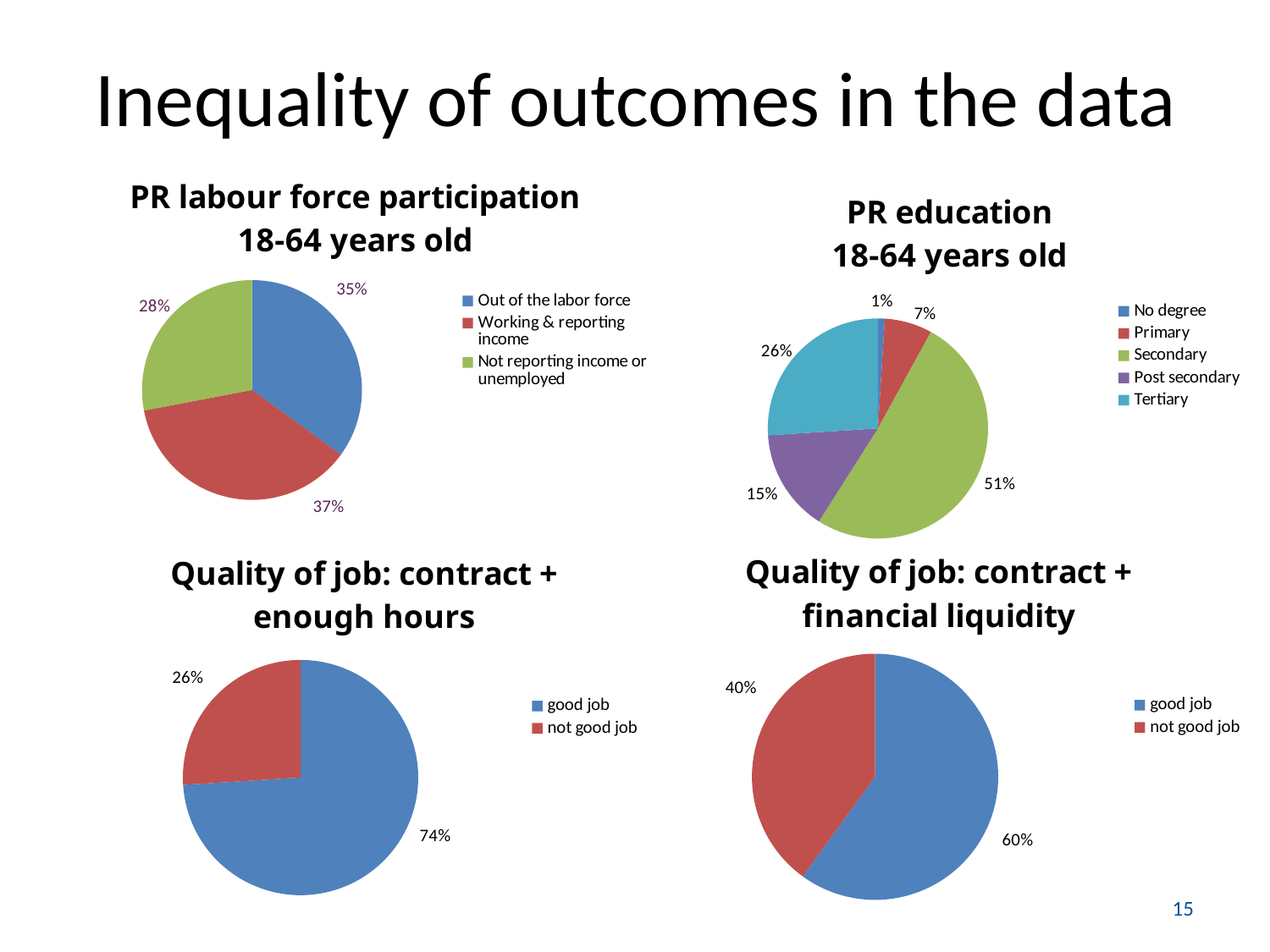
In the 'PR education 18-64 years old' chart, what share is 'Secondary'? 51% In the 'PR labour force participation 18-64 years old' chart, what share is 'Out of the labor force'? 35% In the 'PR education 18-64 years old' chart, which category has the smallest share? No degree In the 'Quality of job: contract + financial liquidity' chart, what share is 'not good job'? 40% In the 'PR labour force participation 18-64 years old' chart, which category has the largest share? Working & reporting income How many charts are shown on the slide? 4 Which is larger: the 'good job' share in the 'Quality of job: contract + enough hours' chart or the 'good job' share in the 'Quality of job: contract + financial liquidity' chart? Quality of job: contract + enough hours What type of chart is the 'Quality of job: contract + financial liquidity' chart? Pie chart In the 'PR education 18-64 years old' chart, what is the difference between the 'Tertiary' and 'Post secondary' shares? 11% How many categories does the legend of the 'PR education 18-64 years old' chart list? 5 In the 'PR labour force participation 18-64 years old' chart, what share is 'Not reporting income or unemployed'? 28% In the 'Quality of job: contract + enough hours' chart, what share is 'good job'? 74%